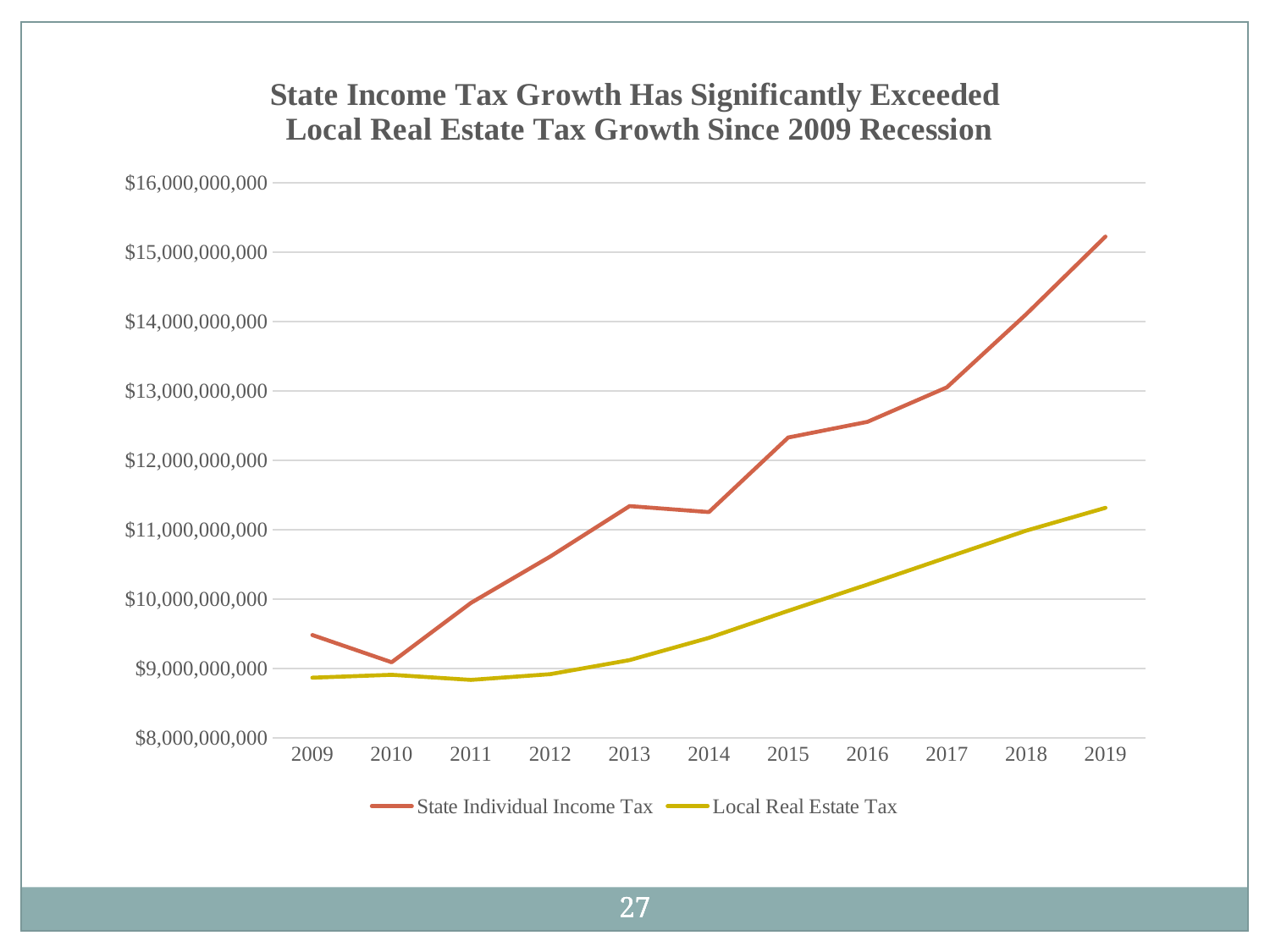
What is the title of the chart? State Income Tax Growth Has Significantly Exceeded Local Real Estate Tax Growth Since 2009 Recession How many series does the legend list? 2 Does Local Real Estate Tax generally rise or fall from 2011 to 2019? Rise How many years are plotted along the x axis? 11 In which year is Local Real Estate Tax at its highest? 2019 In which year is State Individual Income Tax at its lowest? 2010 What kind of chart is shown on the slide? Line chart Which series is higher in 2019, State Individual Income Tax or Local Real Estate Tax? State Individual Income Tax Is the value for State Individual Income Tax in 2019 greater or less than $15,000,000,000? greater Is the value for Local Real Estate Tax in 2019 greater or less than $12,000,000,000? less In which year is State Individual Income Tax at its highest? 2019 Is the value for State Individual Income Tax in 2010 greater or less than $10,000,000,000? less